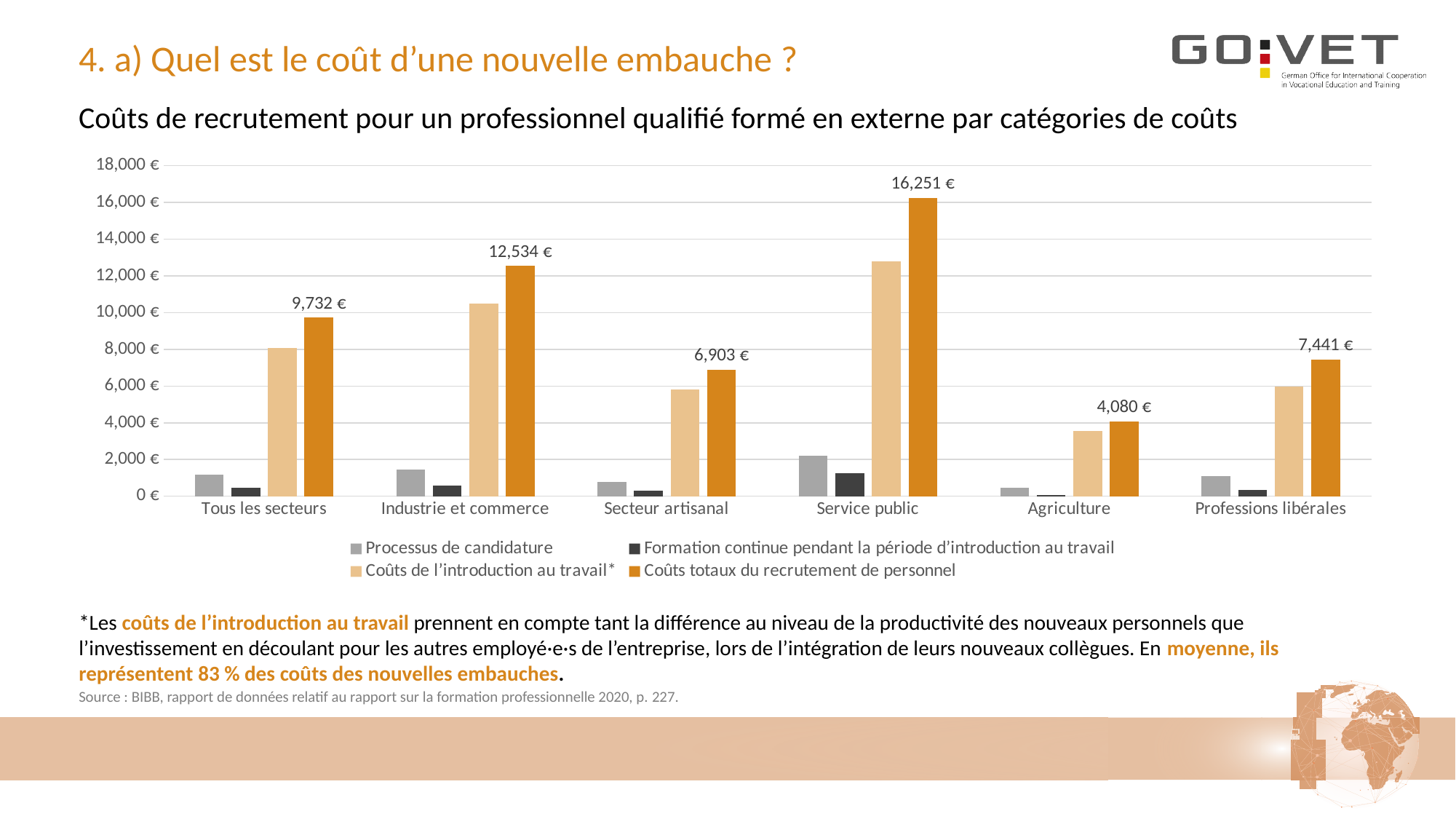
What is the value of 'Coûts totaux du recrutement de personnel' for Tous les secteurs? 9,732 € Which category has the highest 'Coûts totaux du recrutement de personnel'? Service public Which category has the lowest 'Coûts totaux du recrutement de personnel'? Agriculture How many categories are shown on the x axis? 6 Is the value of 'Processus de candidature' for Industrie et commerce greater or less than 2,000 €? less What is the value of 'Coûts totaux du recrutement de personnel' for Service public? 16,251 € Is the value of 'Coûts de l’introduction au travail' for Service public greater or less than 12,000 €? greater Which has the larger 'Coûts totaux du recrutement de personnel': Professions libérales or Secteur artisanal? Professions libérales What kind of chart is shown on the slide? Bar chart What is the difference in 'Coûts totaux du recrutement de personnel' between Industrie et commerce and Secteur artisanal? 5,631 € How many series does the legend list? 4 What is the value of 'Coûts totaux du recrutement de personnel' for Agriculture? 4,080 €